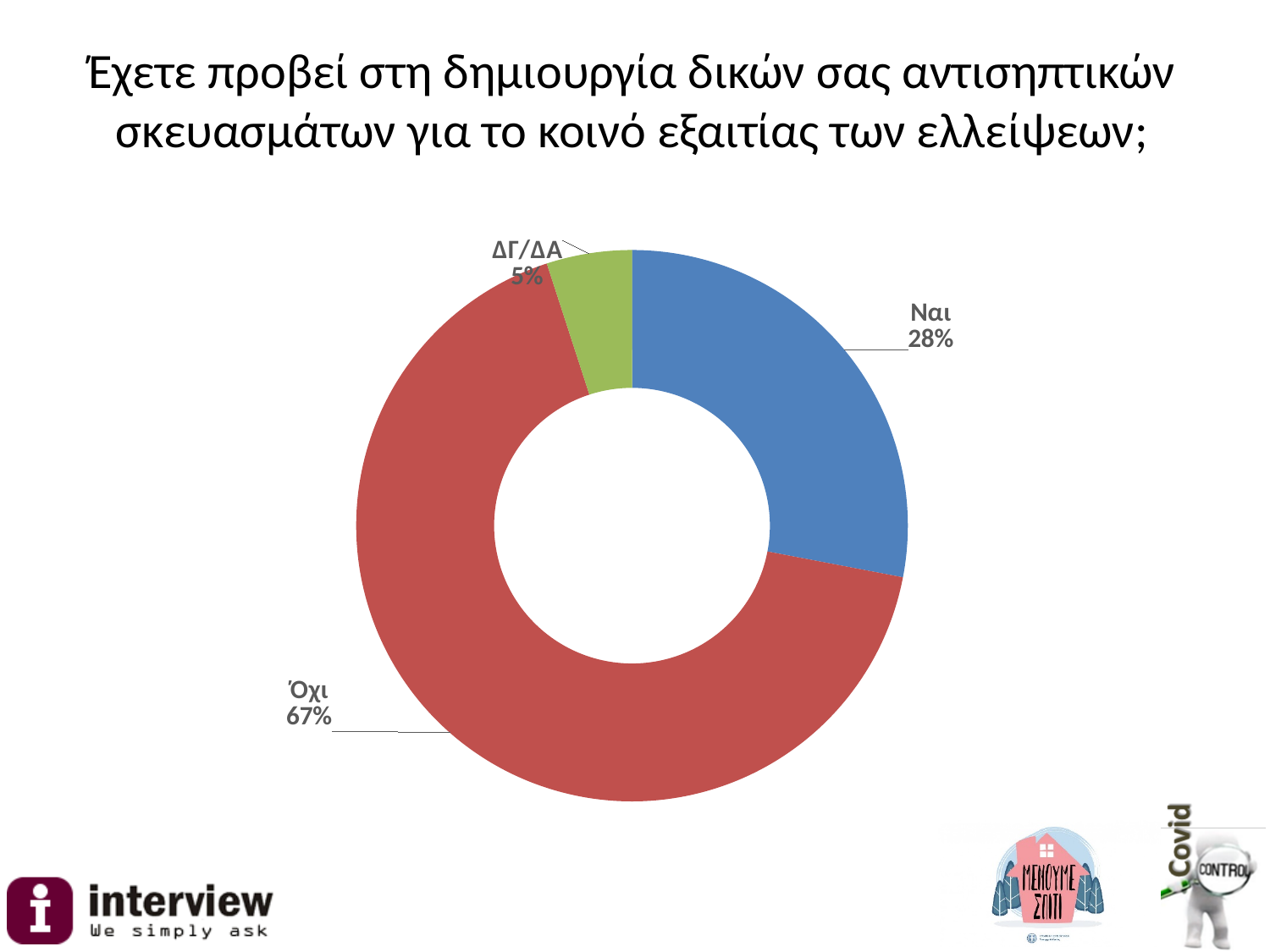
What is the difference in percentage points between Όχι and Ναι? 39 What colour is the Ναι slice? Blue Which is larger, the share for Ναι or the share for ΔΓ/ΔΑ? Ναι What share of respondents answered ΔΓ/ΔΑ? 5% What colour is the Όχι slice? Red Which response has the smallest share of the chart? ΔΓ/ΔΑ What share of respondents answered Ναι? 28% Which response has the largest share of the chart? Όχι What kind of chart is shown on the slide? Doughnut (pie) chart How many categories are shown in the chart? 3 What share of respondents answered Όχι? 67% What is the difference in percentage points between Ναι and ΔΓ/ΔΑ? 23